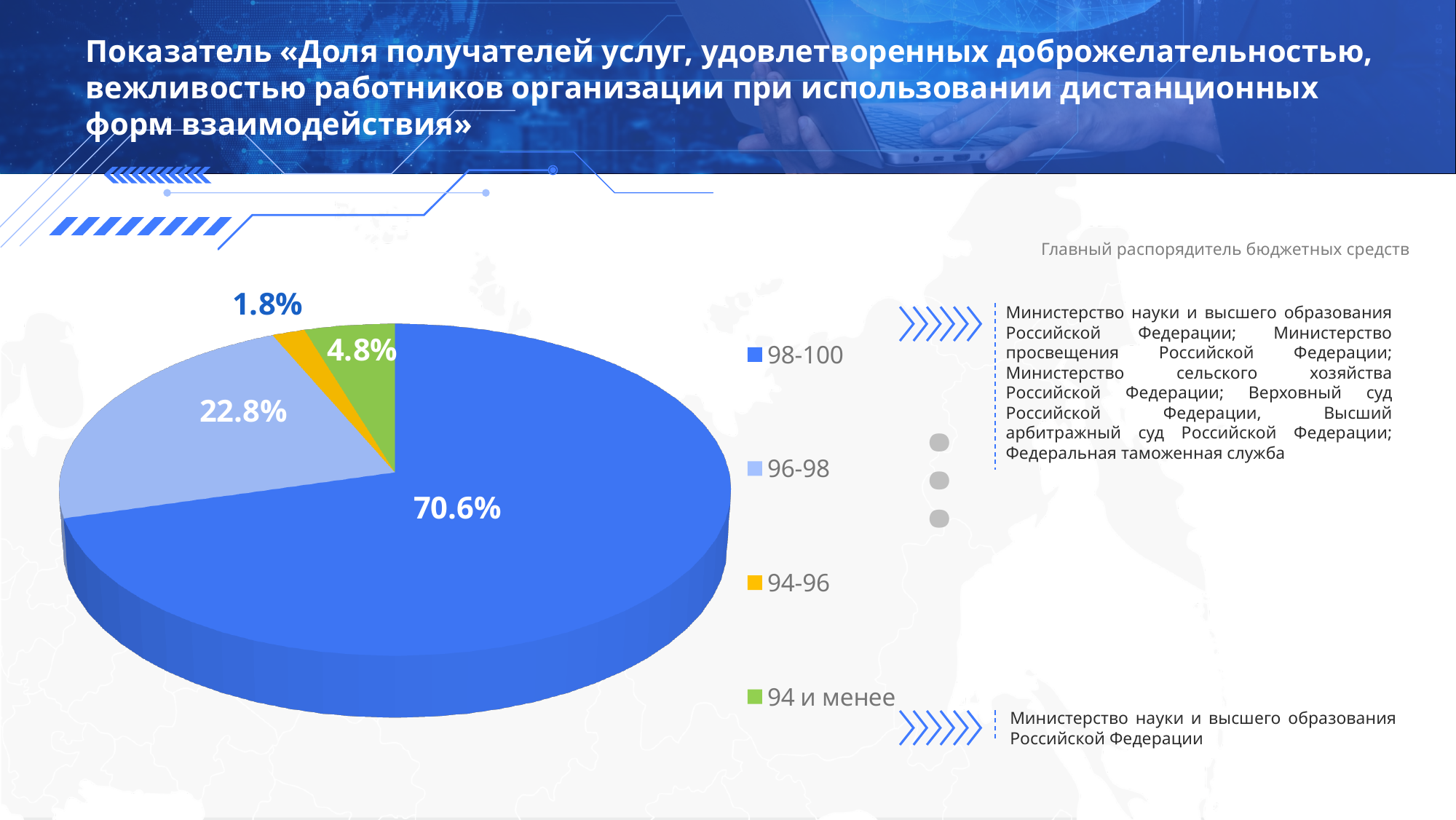
What share of the pie does the "94 и менее" slice have? 4.8% Which category has the largest slice of the pie? 98-100 What is the difference between the "98-100" share and the "96-98" share? 47.8% What type of chart is shown on the slide? pie chart How many slices does the pie chart have? 4 Which category has the smallest slice of the pie? 94-96 What share of the pie does the "96-98" slice have? 22.8% What share of the pie does the "94-96" slice have? 1.8% Which slice is larger: "94 и менее" or "94-96"? 94 и менее What share of the pie does the "98-100" slice have? 70.6% What colour is the "94 и менее" slice in the pie chart? green How many entries does the legend list? 4